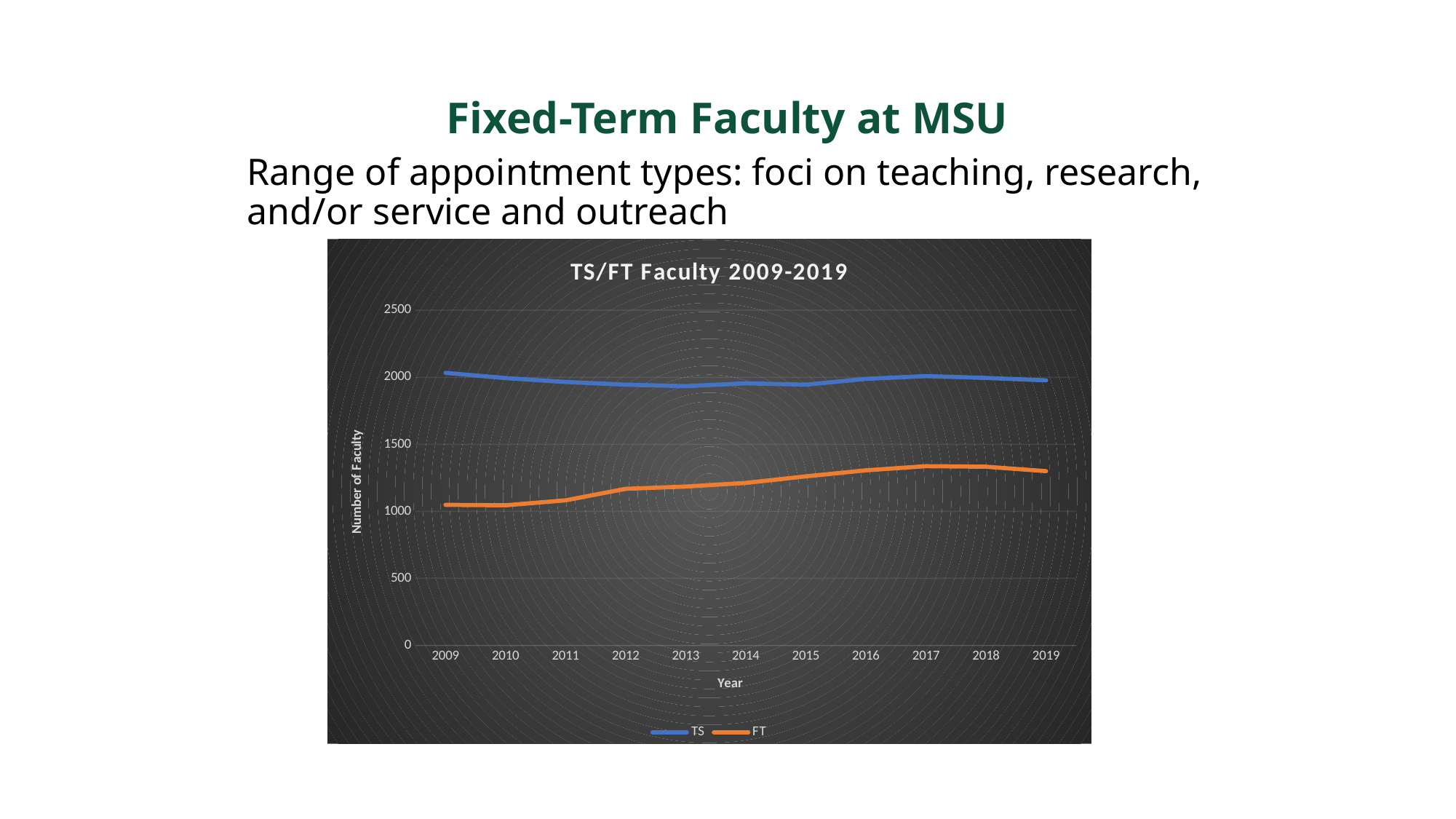
Does the FT series rise or fall from 2009 to 2017? rise Is the value for FT in 2017 greater or less than 1500? less Is the value for TS in 2017 greater or less than 2500? less What is the title of the chart? TS/FT Faculty 2009-2019 How many years are plotted along the x axis of the chart? 11 Is the value for FT in 2009 greater or less than 1000? greater Does the TS series rise or fall from 2009 to 2013? fall Which series has the larger value in 2014, TS or FT? TS What kind of chart is shown on the slide? line chart What is the label on the vertical axis of the chart? Number of Faculty How many series does the chart legend list? 2